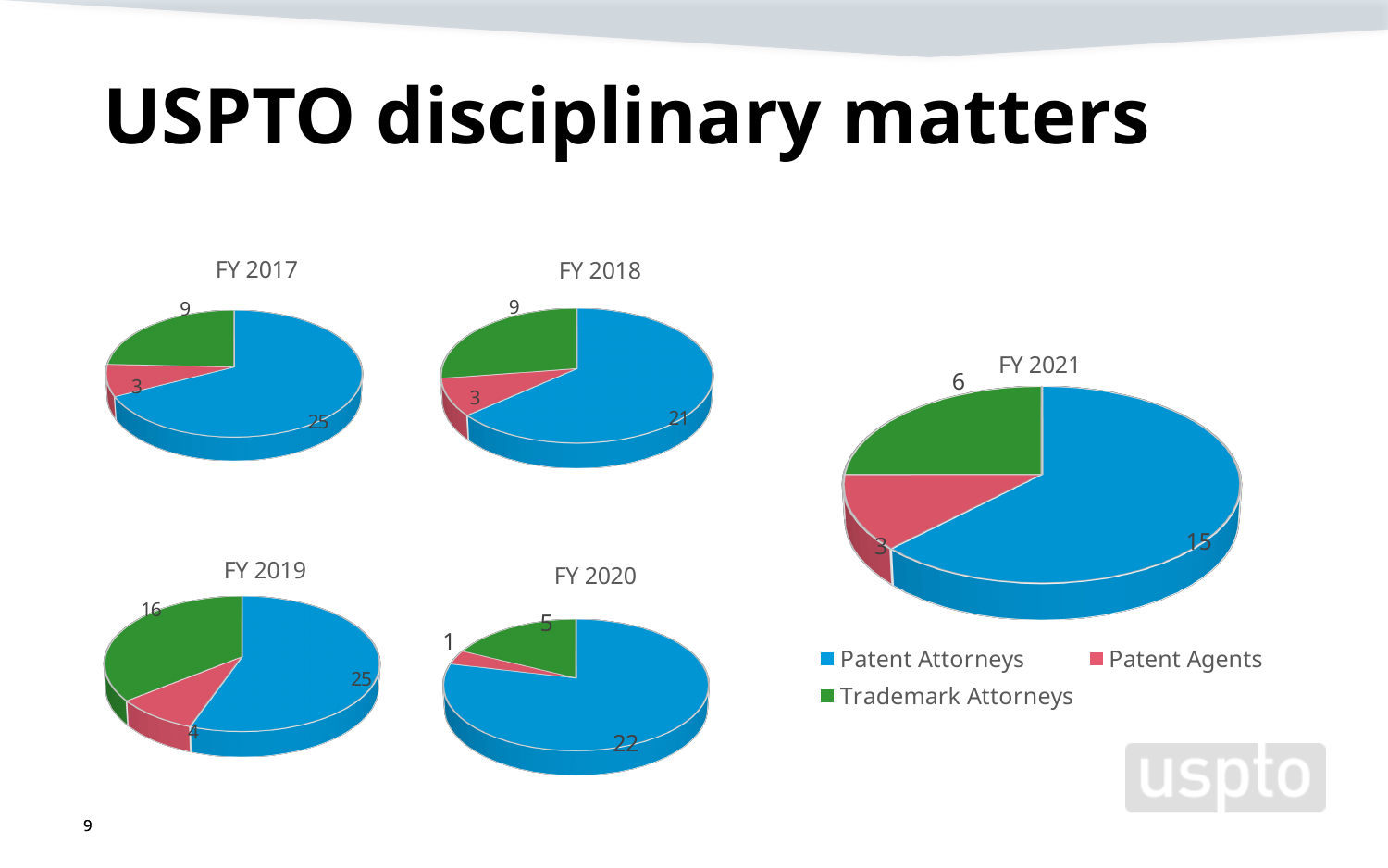
In the FY 2019 chart, what is the value for Patent Agents? 4 In the FY 2021 chart, what share of the total do Patent Attorneys represent? 62.5% In the FY 2019 chart, what is the difference between Patent Attorneys and Trademark Attorneys? 9 Which is larger: Patent Attorneys in FY 2018 or Patent Attorneys in FY 2020? FY 2020 In the FY 2019 chart, which category has the largest slice? Patent Attorneys In the FY 2021 chart, what is the value for Patent Attorneys? 15 How many pie charts are shown on the slide? 5 In the FY 2017 chart, what is the value for Patent Attorneys? 25 In the FY 2018 chart, what is the value for Trademark Attorneys? 9 How many categories does the legend list? 3 In the FY 2020 chart, what is the value for Patent Agents? 1 In the FY 2020 chart, which category has the smallest slice? Patent Agents